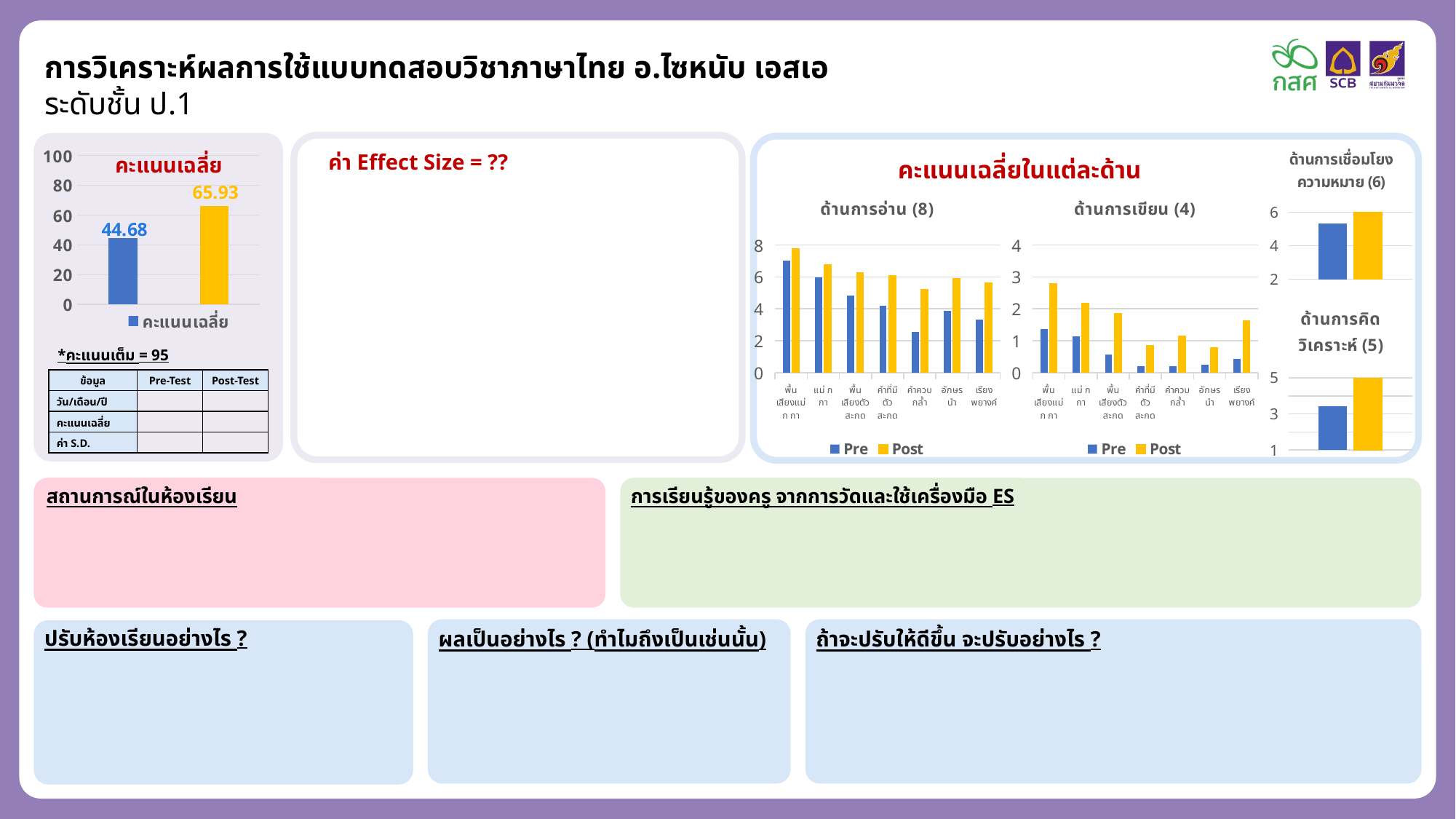
In the คะแนนเฉลี่ย chart on the left, what is the value of the blue bar? 44.68 In the คะแนนเฉลี่ย chart on the left, which bar is larger, the blue one or the yellow one? the yellow one (65.93) In the คะแนนเฉลี่ย chart on the left, what is the value of the yellow bar? 65.93 In the ด้านการอ่าน (8) chart, is the Post value for พื้นเสียงแม่ ก กา greater or less than 6? greater In the ด้านการอ่าน (8) chart, how many series does the legend list? 2 In the ด้านการเขียน (4) chart, is the Pre value for คำที่มีตัวสะกด greater or less than 1? less In the คะแนนเฉลี่ย chart on the left, what is the difference between the yellow bar and the blue bar? 21.25 In the ด้านการเชื่อมโยงความหมาย (6) chart, is the Pre (blue) bar greater or less than 4? greater In the ด้านการอ่าน (8) chart, which category has the highest Post value? พื้นเสียงแม่ ก กา What kind of chart is the คะแนนเฉลี่ย chart on the left? bar chart In the ด้านการอ่าน (8) chart, how many categories are shown on the x axis? 7 What are the two legend entries in the ด้านการเขียน (4) chart? Pre and Post